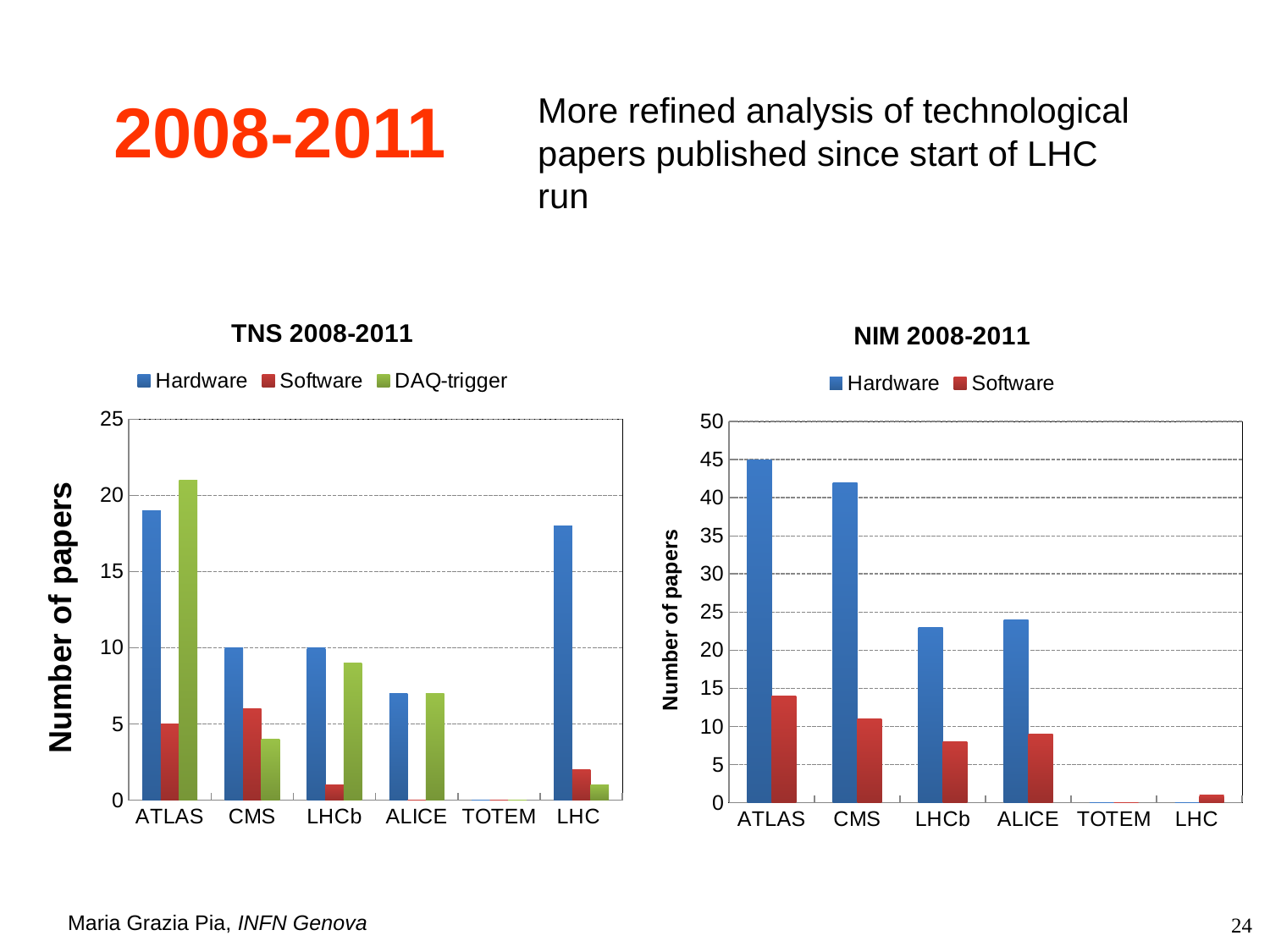
On the NIM 2008-2011 chart, is the Software value for ALICE greater or less than 10? less What kind of chart is the NIM 2008-2011 chart? Bar chart On the TNS 2008-2011 chart, is the DAQ-trigger value for ATLAS greater or less than 20? greater What is the y-axis title of the TNS 2008-2011 chart? Number of papers On the TNS 2008-2011 chart, how many series does the legend list? 3 On the NIM 2008-2011 chart, which category has the highest Hardware value? ATLAS On the TNS 2008-2011 chart, which category has the highest DAQ-trigger value? ATLAS On the NIM 2008-2011 chart, which is larger: the Software value for ATLAS or the Software value for CMS? ATLAS On the TNS 2008-2011 chart, which is larger: the Hardware value for CMS or the Hardware value for ALICE? CMS On the NIM 2008-2011 chart, is the Hardware value for CMS greater or less than 40? greater On the TNS 2008-2011 chart, how many categories are shown on the x axis? 6 On the NIM 2008-2011 chart, how many series does the legend list? 2